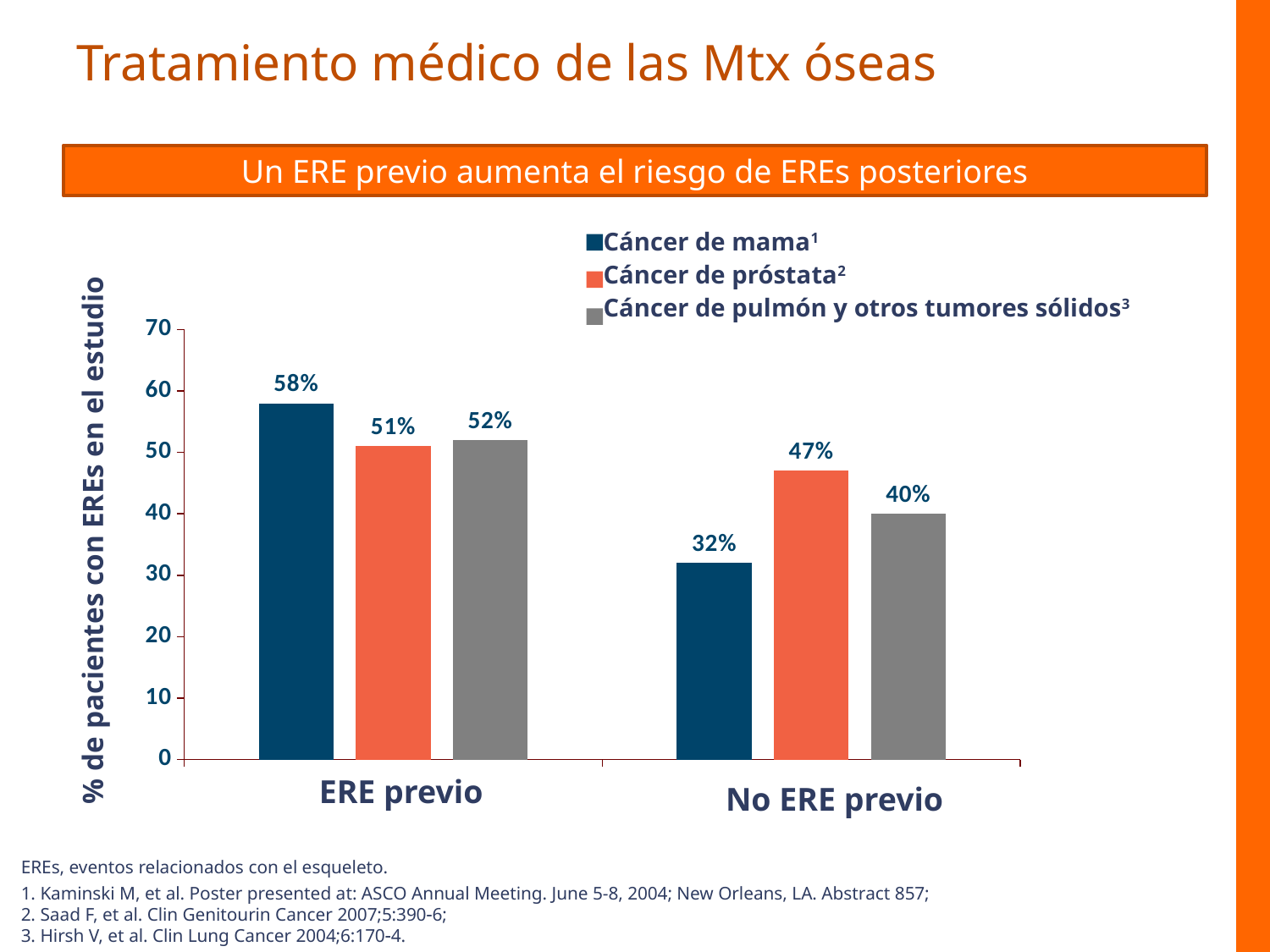
What is the value for Cáncer de mama in the ERE previo group? 58% What is the difference between the Cáncer de mama values for ERE previo and No ERE previo? 26% What is the label of the y axis? % de pacientes con EREs en el estudio What kind of chart is shown on the slide? Bar chart How many series does the legend list? 3 Which series has the highest value in the ERE previo group? Cáncer de mama Which is larger: Cáncer de próstata in ERE previo or Cáncer de próstata in No ERE previo? ERE previo What is the value for Cáncer de mama in the No ERE previo group? 32% What is the difference between the Cáncer de pulmón y otros tumores sólidos values for ERE previo and No ERE previo? 12% What is the value for Cáncer de pulmón y otros tumores sólidos in the ERE previo group? 52% Which series has the lowest value in the No ERE previo group? Cáncer de mama What is the value for Cáncer de próstata in the No ERE previo group? 47%